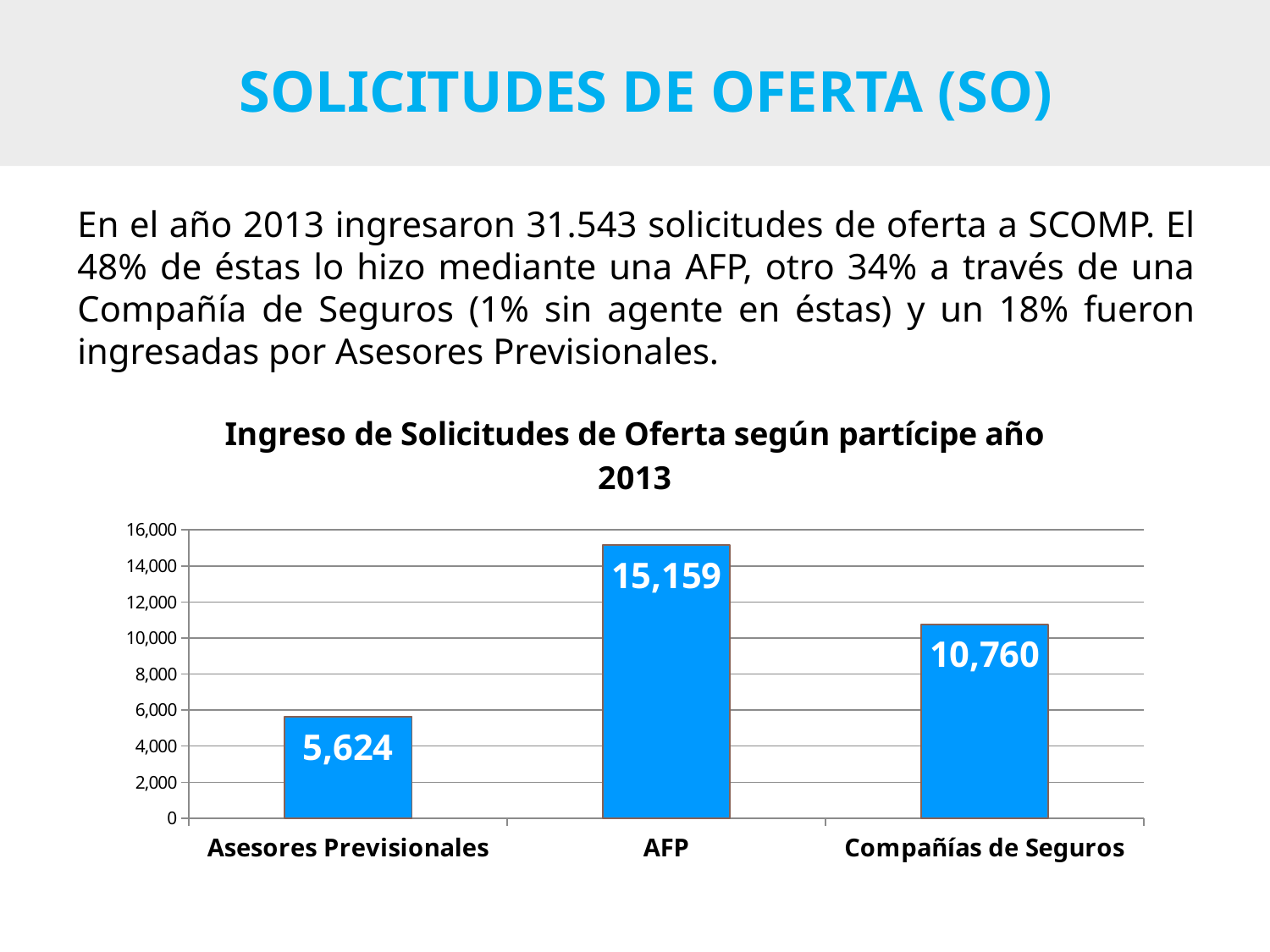
What is the difference between the values for Compañías de Seguros and Asesores Previsionales? 5,136 Which category has the highest value? AFP What is the difference between the values for AFP and Compañías de Seguros? 4,399 Which category has the lowest value? Asesores Previsionales What is the value for Compañías de Seguros? 10,760 How many categories are shown in the chart? 3 Which is larger, the value for Compañías de Seguros or the value for Asesores Previsionales? Compañías de Seguros What is the value for Asesores Previsionales? 5,624 Is the value for AFP greater or less than 14,000? greater What is the value for AFP? 15,159 What kind of chart is shown on the slide? Bar chart What is the title of the chart? Ingreso de Solicitudes de Oferta según partícipe año 2013